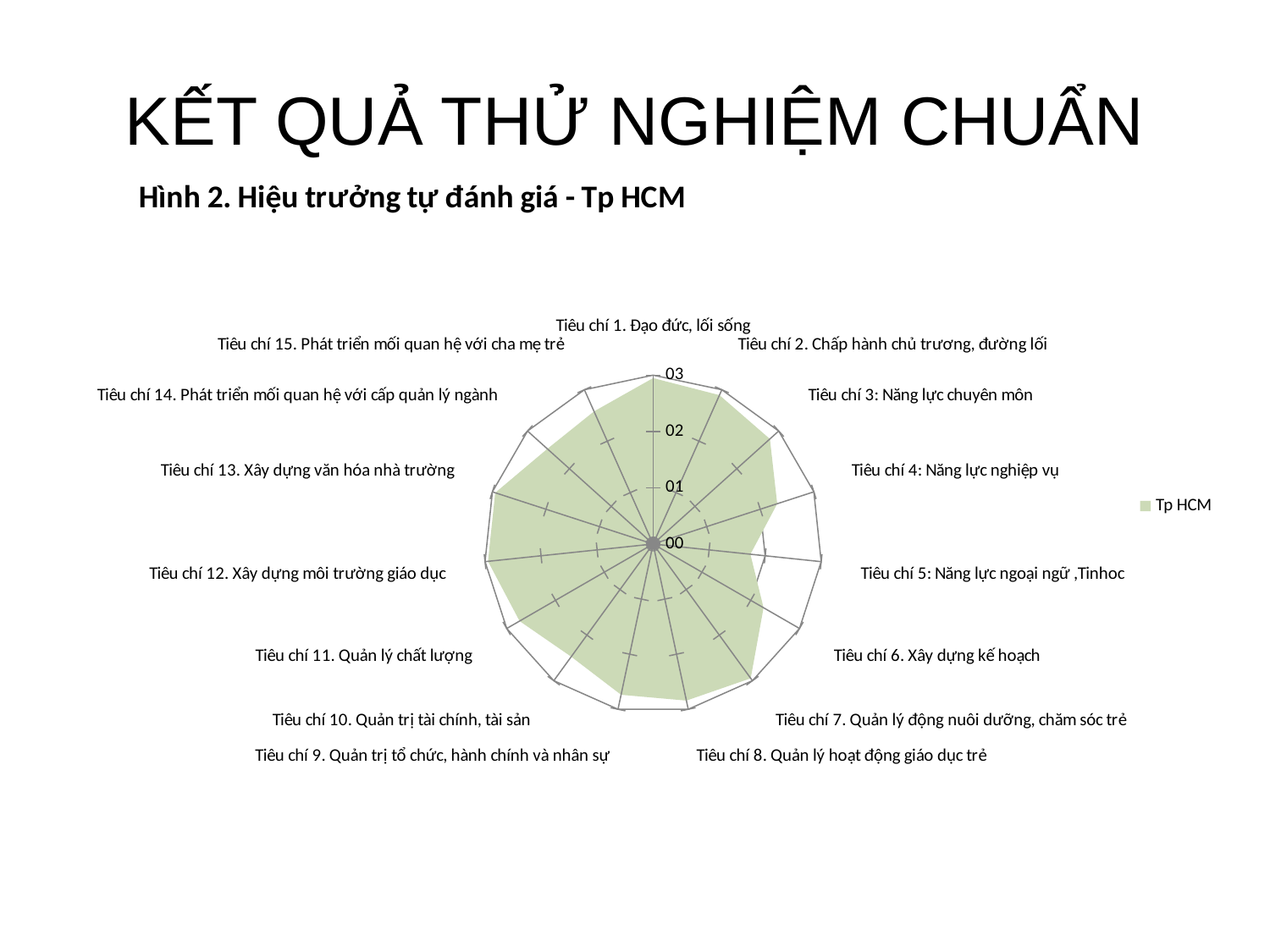
Which has the larger value, Tiêu chí 12. Xây dựng môi trường giáo dục or Tiêu chí 4: Năng lực nghiệp vụ? Tiêu chí 12. Xây dựng môi trường giáo dục How many criteria (categories) are plotted on the radar chart? 15 What is the highest value marked on the radar chart's axis scale? 03 What is the name of the series shown in the legend? Tp HCM What kind of chart is shown on the slide? Radar chart How many series does the legend list? 1 Is the value for Tiêu chí 5: Năng lực ngoại ngữ ,Tinhoc greater or less than 03? less Is the value for Tiêu chí 5: Năng lực ngoại ngữ ,Tinhoc greater or less than 01? greater Is the value for Tiêu chí 1. Đạo đức, lối sống greater or less than 02? greater Which has the larger value, Tiêu chí 1. Đạo đức, lối sống or Tiêu chí 5: Năng lực ngoại ngữ ,Tinhoc? Tiêu chí 1. Đạo đức, lối sống What is the title of the chart? Hình 2. Hiệu trưởng tự đánh giá - Tp HCM